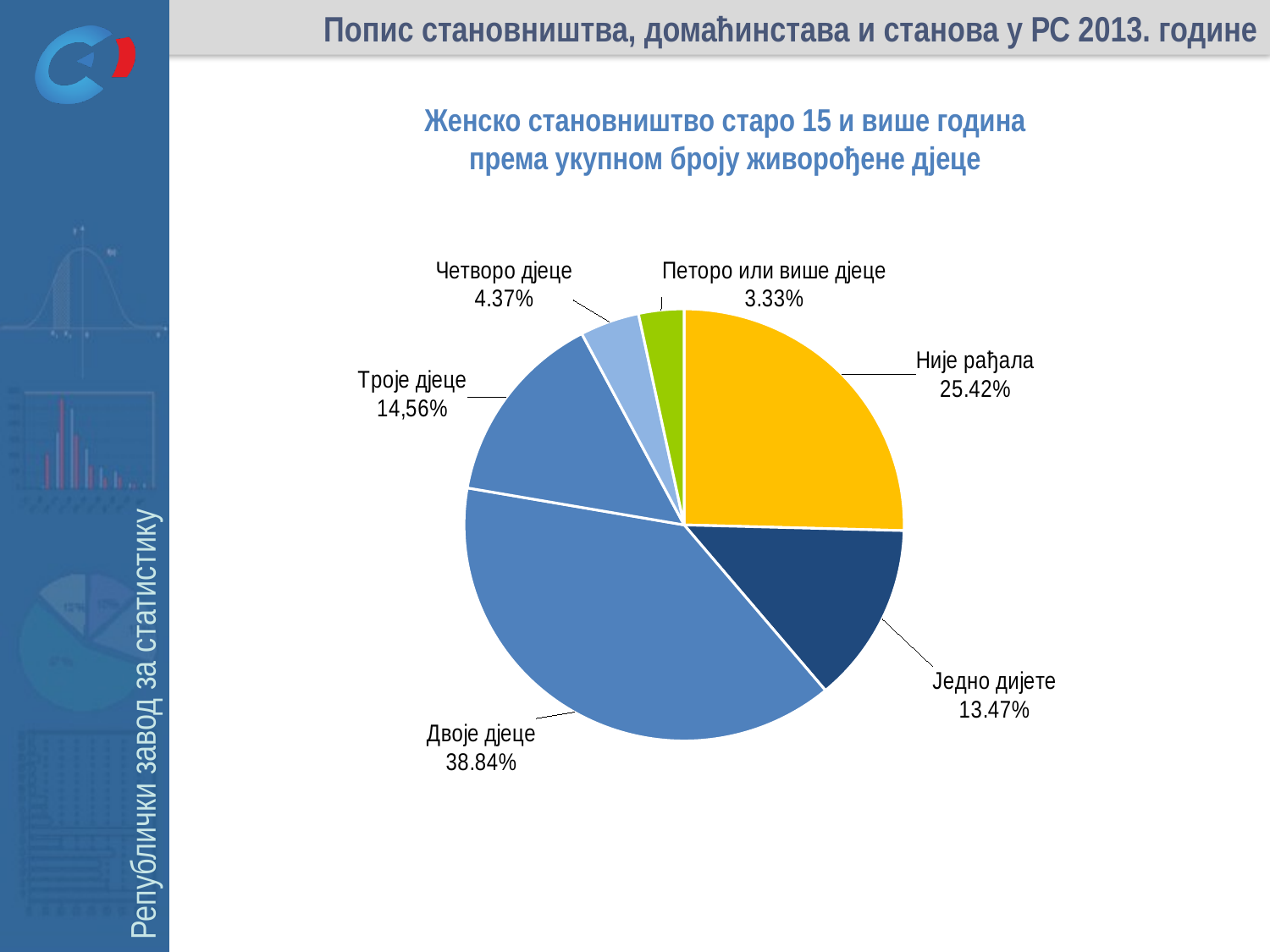
What colour is the slice for "Није рађала"? Yellow What is the value shown for "Није рађала"? 25.42% How many slices does the pie chart have? 6 Which category has the smallest slice of the pie? Петоро или више дјеце Which is larger, the share for "Није рађала" or for "Једно дијете"? Није рађала What type of chart is shown on the slide? Pie chart Which category has the largest slice of the pie? Двоје дјеце What value is printed for "Троје дјеце"? 14,56% What share of the pie is labelled "Двоје дјеце"? 38.84% What percentage is shown for "Петоро или више дјеце"? 3.33% What percentage is shown for "Једно дијете"? 13.47% What is the difference in percentage points between "Двоје дјеце" and "Није рађала"? 13.42